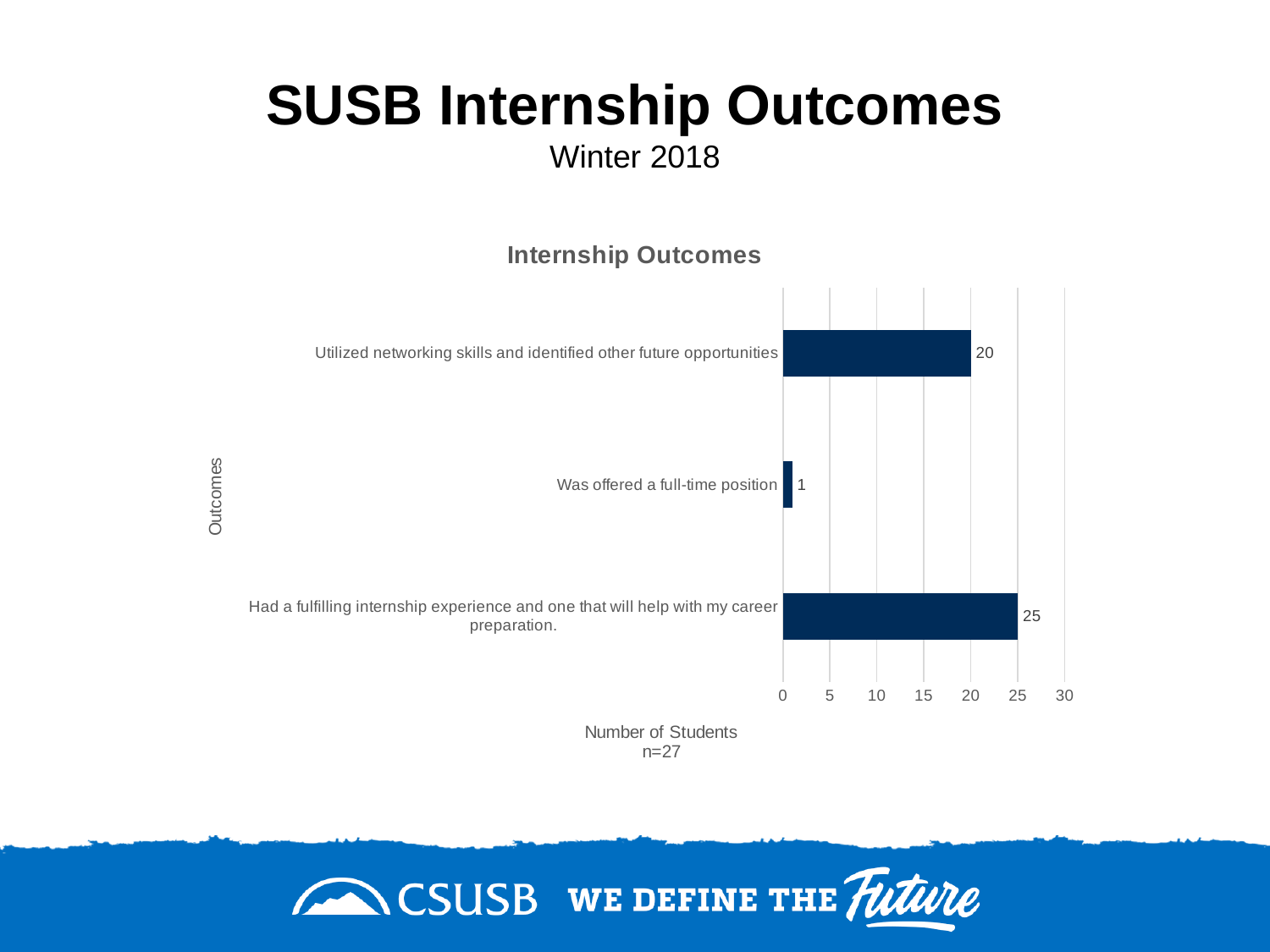
Is the value for "Utilized networking skills and identified other future opportunities" greater or less than 15? greater What is the x-axis label of the chart? Number of Students n=27 Which outcome has the highest number of students? Had a fulfilling internship experience and one that will help with my career preparation. What is the value for "Had a fulfilling internship experience and one that will help with my career preparation."? 25 What kind of chart is shown on the slide? bar chart How many outcome categories are shown in the chart? 3 Which outcome has the lowest number of students? Was offered a full-time position What is the title of the chart? Internship Outcomes Which is larger: the value for "Utilized networking skills and identified other future opportunities" or the value for "Was offered a full-time position"? Utilized networking skills and identified other future opportunities How many students utilized networking skills and identified other future opportunities? 20 What is the value for "Was offered a full-time position"? 1 What is the difference between the number of students who had a fulfilling internship experience and those who utilized networking skills? 5